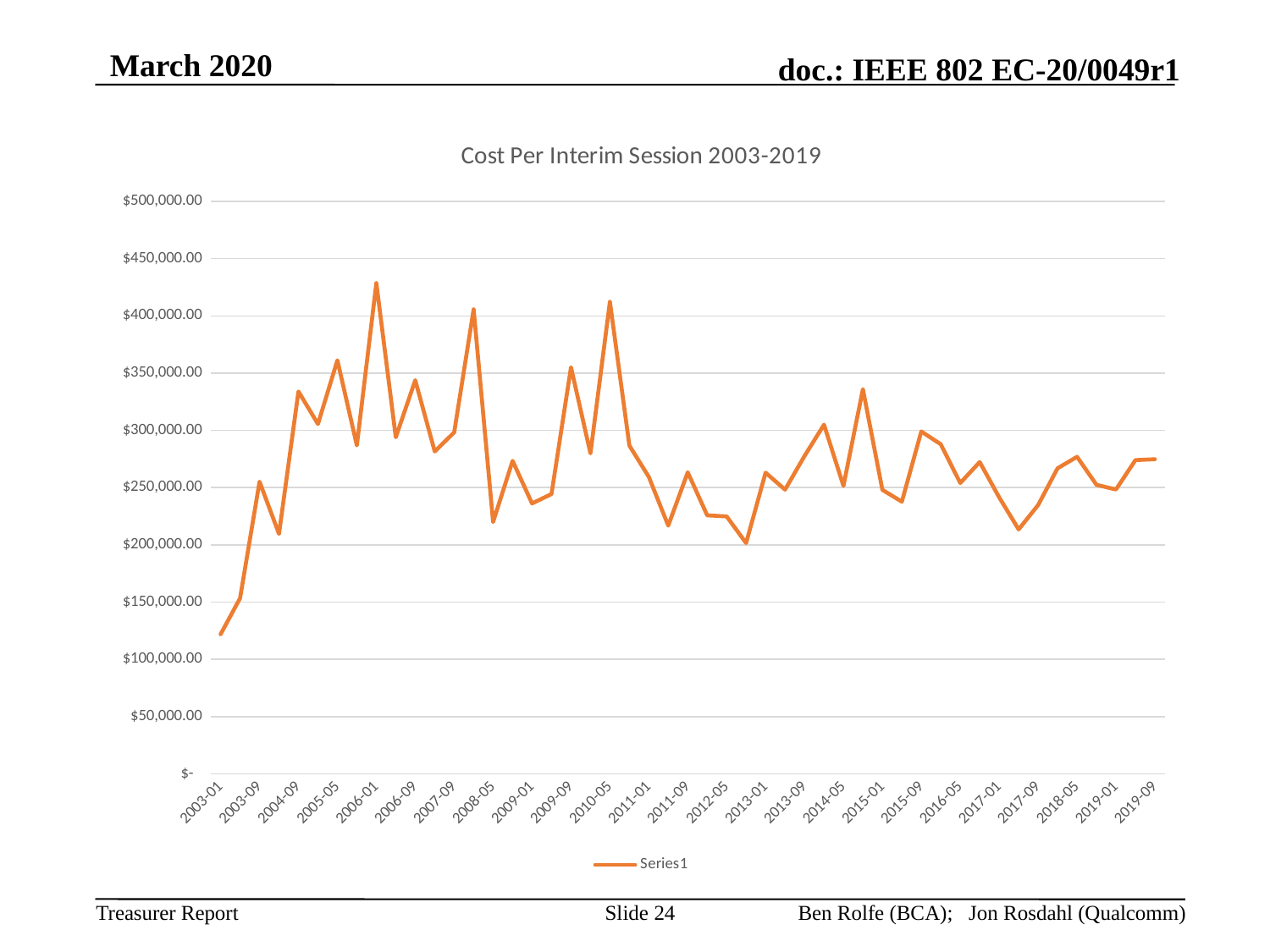
What kind of chart is shown on the slide? line chart Is the value for 2010-05 greater or less than $400,000.00? greater At which x-axis label does the line have its lowest value? 2003-01 How many series does the legend list? 1 What is the name of the series shown in the legend? Series1 What is the title of the chart? Cost Per Interim Session 2003-2019 Is the value for 2003-01 greater or less than $150,000.00? less Which has the larger value, 2003-01 or 2006-01? 2006-01 At which x-axis label does the line reach its highest value? 2006-01 Does the line rise or fall between 2003-01 and 2003-09? rise Is the value for 2019-09 greater or less than $250,000.00? greater